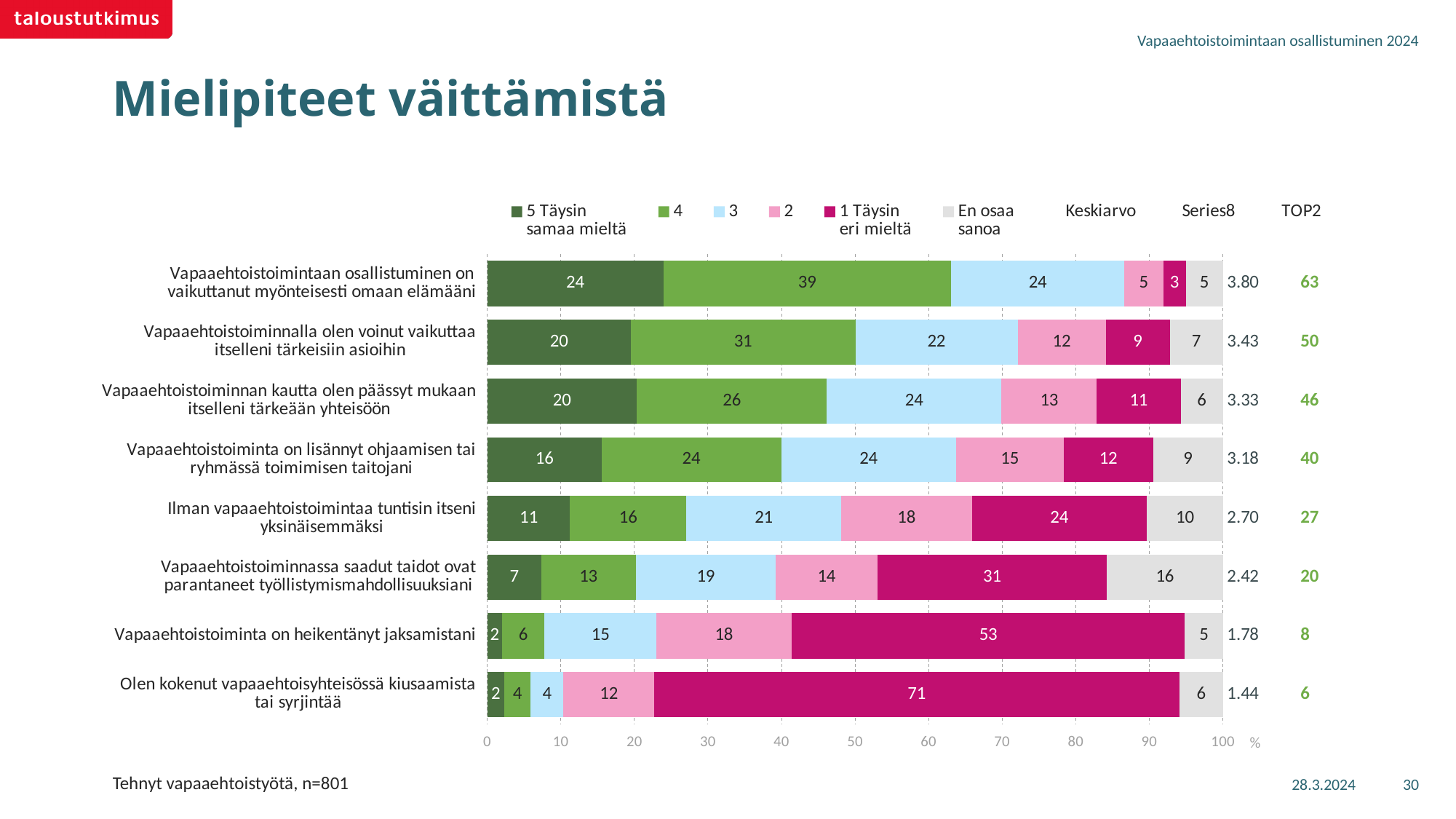
What is the value of '1 Täysin eri mieltä' for 'Olen kokenut vapaaehtoisyhteisössä kiusaamista tai syrjintää'? 71 What is the 'En osaa sanoa' value for 'Vapaaehtoistoiminnassa saadut taidot ovat parantaneet työllistymismahdollisuuksiani'? 16 Which statement has the highest TOP2 value? Vapaaehtoistoimintaan osallistuminen on vaikuttanut myönteisesti omaan elämääni What type of chart is shown on the slide? stacked bar chart What is the Keskiarvo value for 'Vapaaehtoistoiminta on heikentänyt jaksamistani'? 1.78 What is the difference between the '1 Täysin eri mieltä' values for 'Vapaaehtoistoiminta on heikentänyt jaksamistani' and 'Vapaaehtoistoiminnassa saadut taidot ovat parantaneet työllistymismahdollisuuksiani'? 22 What is the sample description given below the chart? Tehnyt vapaaehtoistyötä, n=801 Which statement has the lowest Keskiarvo value? Olen kokenut vapaaehtoisyhteisössä kiusaamista tai syrjintää How many statements (categories) are plotted in the chart? 8 Which is larger: the '4' value for 'Vapaaehtoistoiminnan kautta olen päässyt mukaan itselleni tärkeään yhteisöön' or the '4' value for 'Vapaaehtoistoiminta on lisännyt ohjaamisen tai ryhmässä toimimisen taitojani'? Vapaaehtoistoiminnan kautta olen päässyt mukaan itselleni tärkeään yhteisöön What is the TOP2 value for 'Vapaaehtoistoiminnalla olen voinut vaikuttaa itselleni tärkeisiin asioihin'? 50 What is the value of '5 Täysin samaa mieltä' for 'Vapaaehtoistoimintaan osallistuminen on vaikuttanut myönteisesti omaan elämääni'? 24